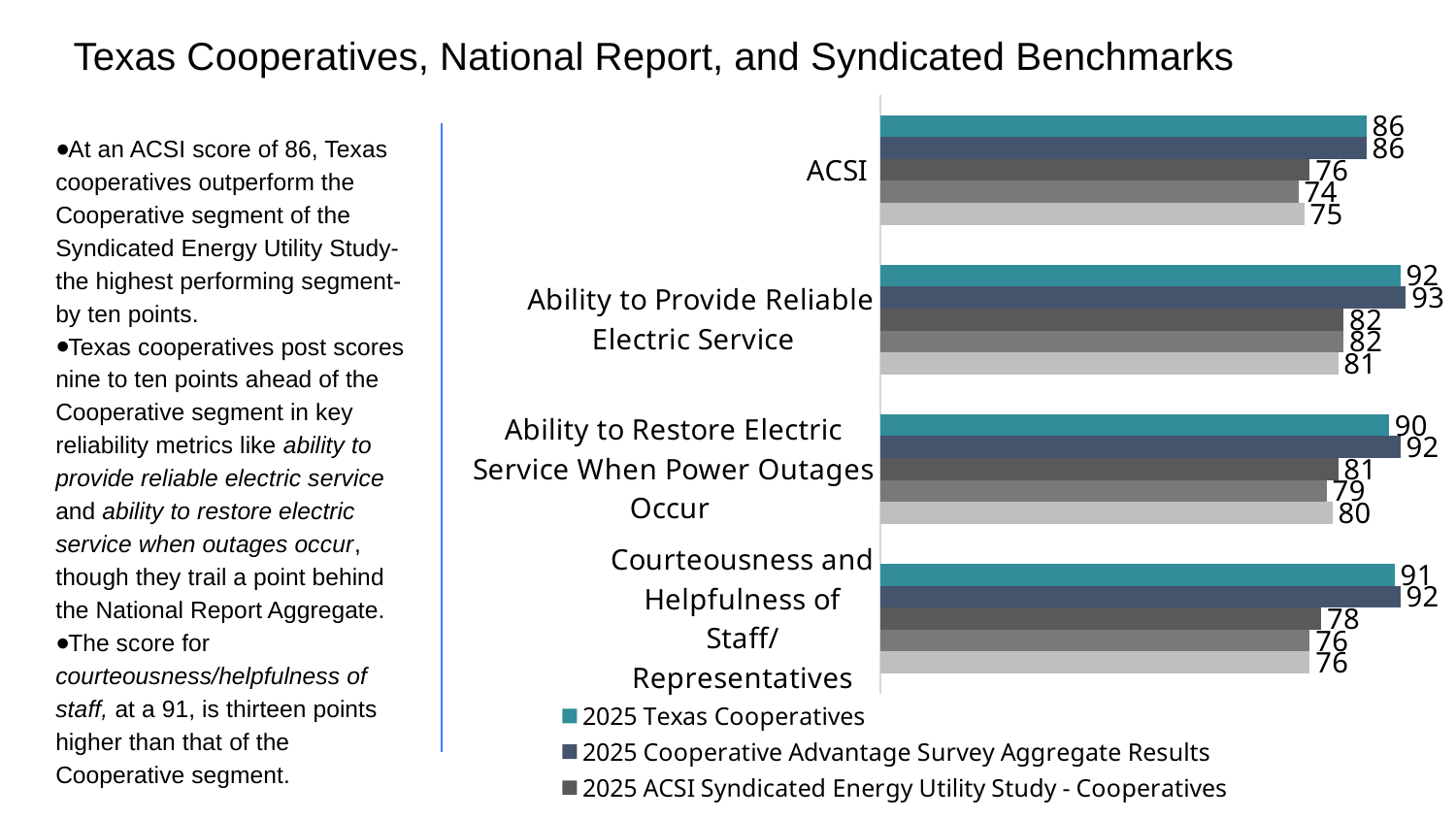
For Courteousness and Helpfulness of Staff/Representatives, what is the difference between the 2025 Texas Cooperatives value and the 2025 ACSI Syndicated Energy Utility Study - Cooperatives value? 13 What is the 2025 ACSI Syndicated Energy Utility Study - Cooperatives value for Courteousness and Helpfulness of Staff/Representatives? 78 What kind of chart is shown on the slide? Bar chart For Ability to Provide Reliable Electric Service, what is the difference between the 2025 Texas Cooperatives value and the 2025 ACSI Syndicated Energy Utility Study - Cooperatives value? 10 Which category has the lowest 2025 Texas Cooperatives value? ACSI Which category has the highest 2025 Texas Cooperatives value? Ability to Provide Reliable Electric Service What colour represents 2025 Texas Cooperatives in the chart? Teal For Ability to Restore Electric Service When Power Outages Occur, which is larger: the 2025 Texas Cooperatives value or the 2025 Cooperative Advantage Survey Aggregate Results value? 2025 Cooperative Advantage Survey Aggregate Results How many categories are shown on the chart? 4 What is the 2025 Texas Cooperatives value for ACSI? 86 What is the 2025 Cooperative Advantage Survey Aggregate Results value for Ability to Provide Reliable Electric Service? 93 What is the 2025 ACSI Syndicated Energy Utility Study - Cooperatives value for ACSI? 76